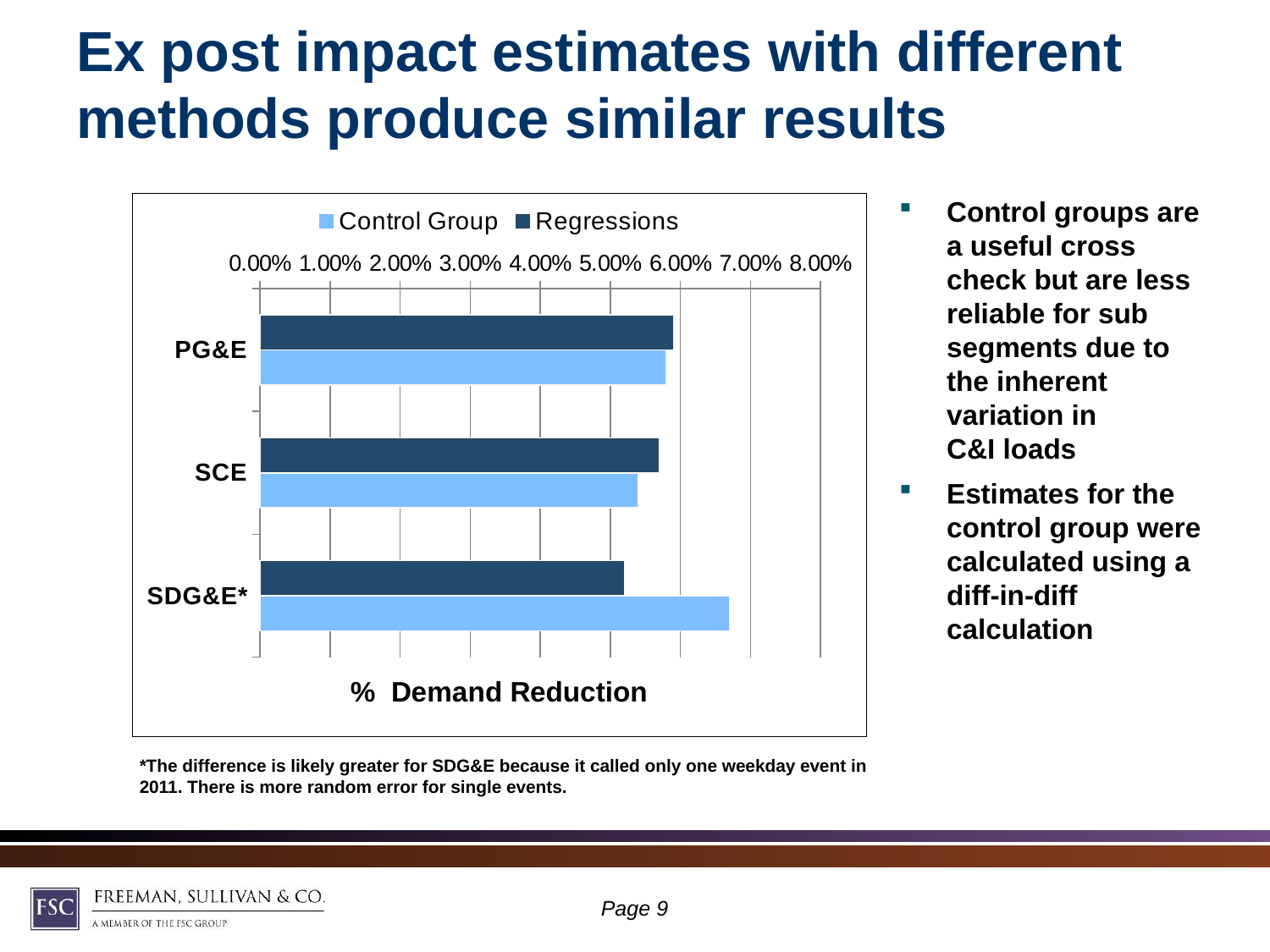
Which series are listed in the chart legend? Control Group and Regressions Which utility has the highest Control Group value? SDG&E* Which utility has the lowest Regressions value? SDG&E* Is the Control Group value for SDG&E* greater or less than 6.00%? greater Is the Control Group value for SCE greater or less than 6.00%? less How many utilities (categories) are shown on the chart? 3 Is the Regressions value for PG&E greater or less than 5.00%? greater How many series does the chart legend list? 2 What is the axis title shown below the chart? % Demand Reduction What kind of chart is shown on the slide? Bar chart For SDG&E*, which is larger: the Control Group value or the Regressions value? Control Group